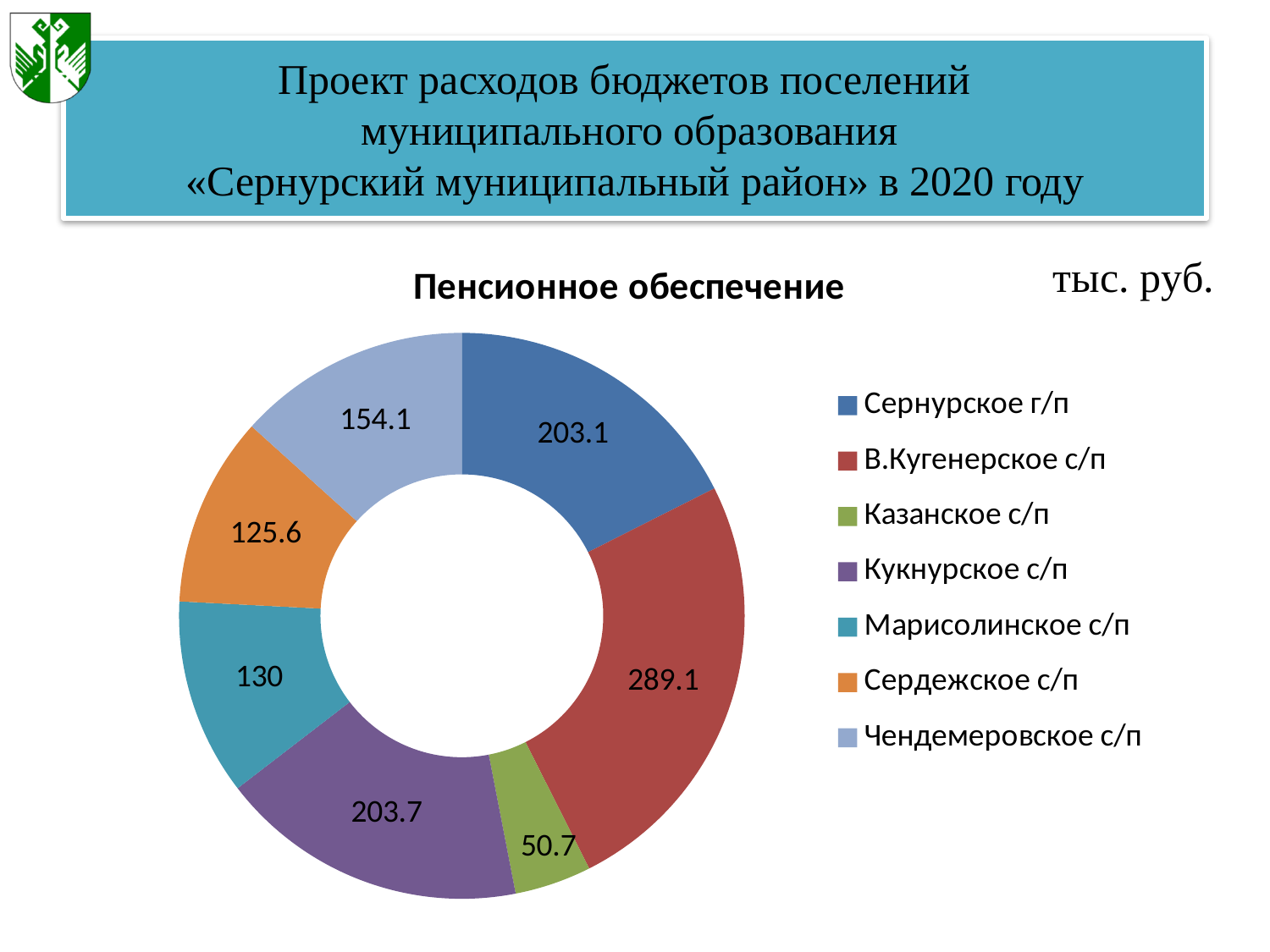
What is the value for В.Кугенерское с/п in the Пенсионное обеспечение chart? 289.1 What unit is indicated for the values in the chart? тыс. руб. Which settlement has the largest value in the Пенсионное обеспечение chart? В.Кугенерское с/п What kind of chart is used for Пенсионное обеспечение? Doughnut (pie) chart What is the value for Марисолинское с/п in the Пенсионное обеспечение chart? 130 How many settlements are shown in the Пенсионное обеспечение chart? 7 What is the value for Чендемеровское с/п in the Пенсионное обеспечение chart? 154.1 What is the difference between the values for Чендемеровское с/п and Сердежское с/п? 28.5 Which is larger, the value for Марисолинское с/п or the value for Сердежское с/п? Марисолинское с/п Which settlement has the smallest value in the Пенсионное обеспечение chart? Казанское с/п What is the difference between the values for В.Кугенерское с/п and Казанское с/п? 238.4 What is the value for Казанское с/п in the Пенсионное обеспечение chart? 50.7